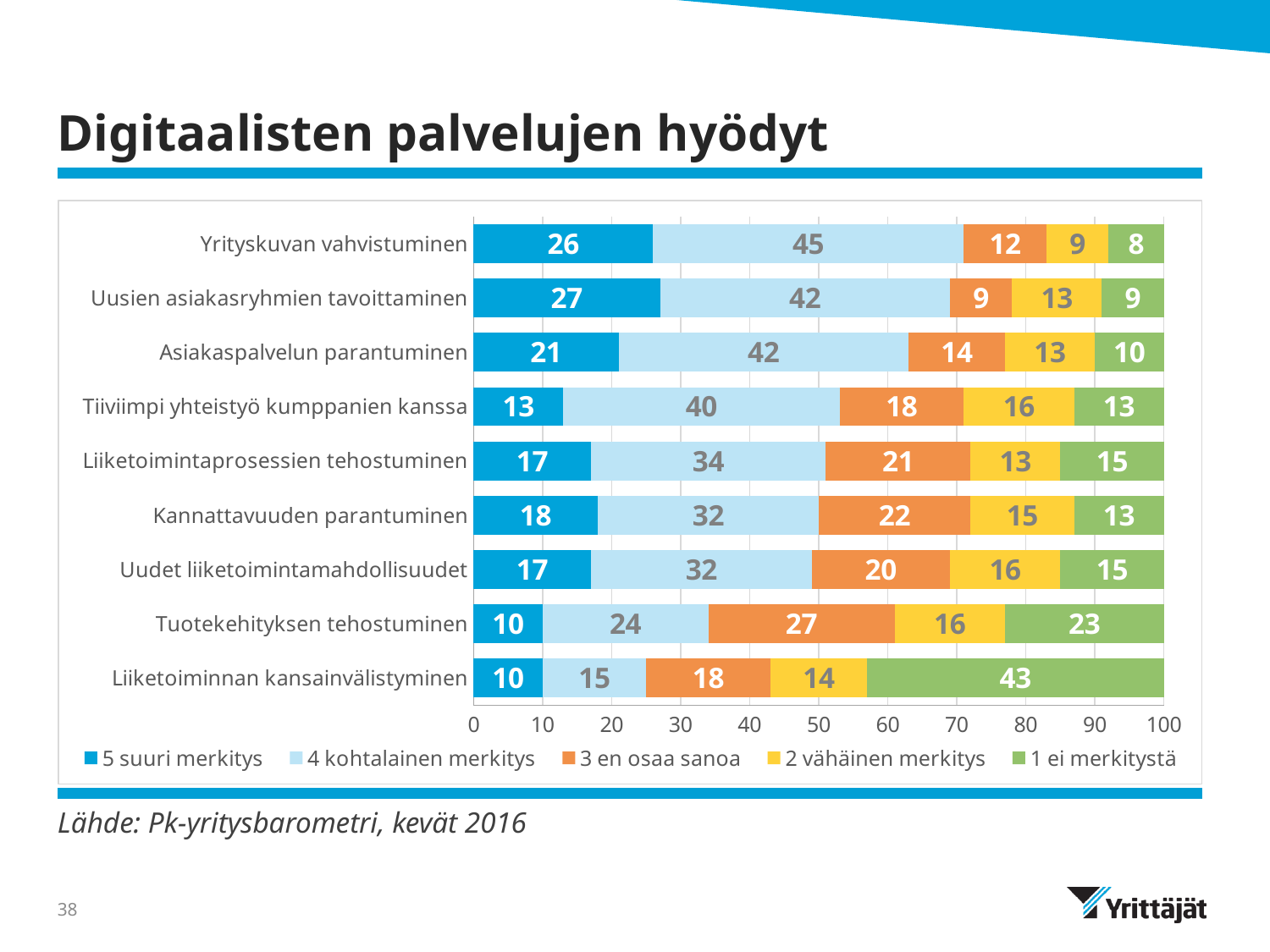
What is the value of "3 en osaa sanoa" for Tuotekehityksen tehostuminen? 27 What is the value of "1 ei merkitystä" for Liiketoiminnan kansainvälistyminen? 43 What is the title of the chart? Digitaalisten palvelujen hyödyt Which is larger: the "2 vähäinen merkitys" value for Tiiviimpi yhteistyö kumppanien kanssa or for Liiketoimintaprosessien tehostuminen? Tiiviimpi yhteistyö kumppanien kanssa How many categories are shown on the chart? 9 Which category has the lowest value for "4 kohtalainen merkitys"? Liiketoiminnan kansainvälistyminen What is the total of the stacked bar for Kannattavuuden parantuminen? 100 What kind of chart is shown on the slide? Stacked bar chart What is the difference between the "4 kohtalainen merkitys" values for Yrityskuvan vahvistuminen and Tuotekehityksen tehostuminen? 21 Which category has the highest value for "5 suuri merkitys"? Uusien asiakasryhmien tavoittaminen What is the value of "5 suuri merkitys" for Yrityskuvan vahvistuminen? 26 How many series does the legend list? 5